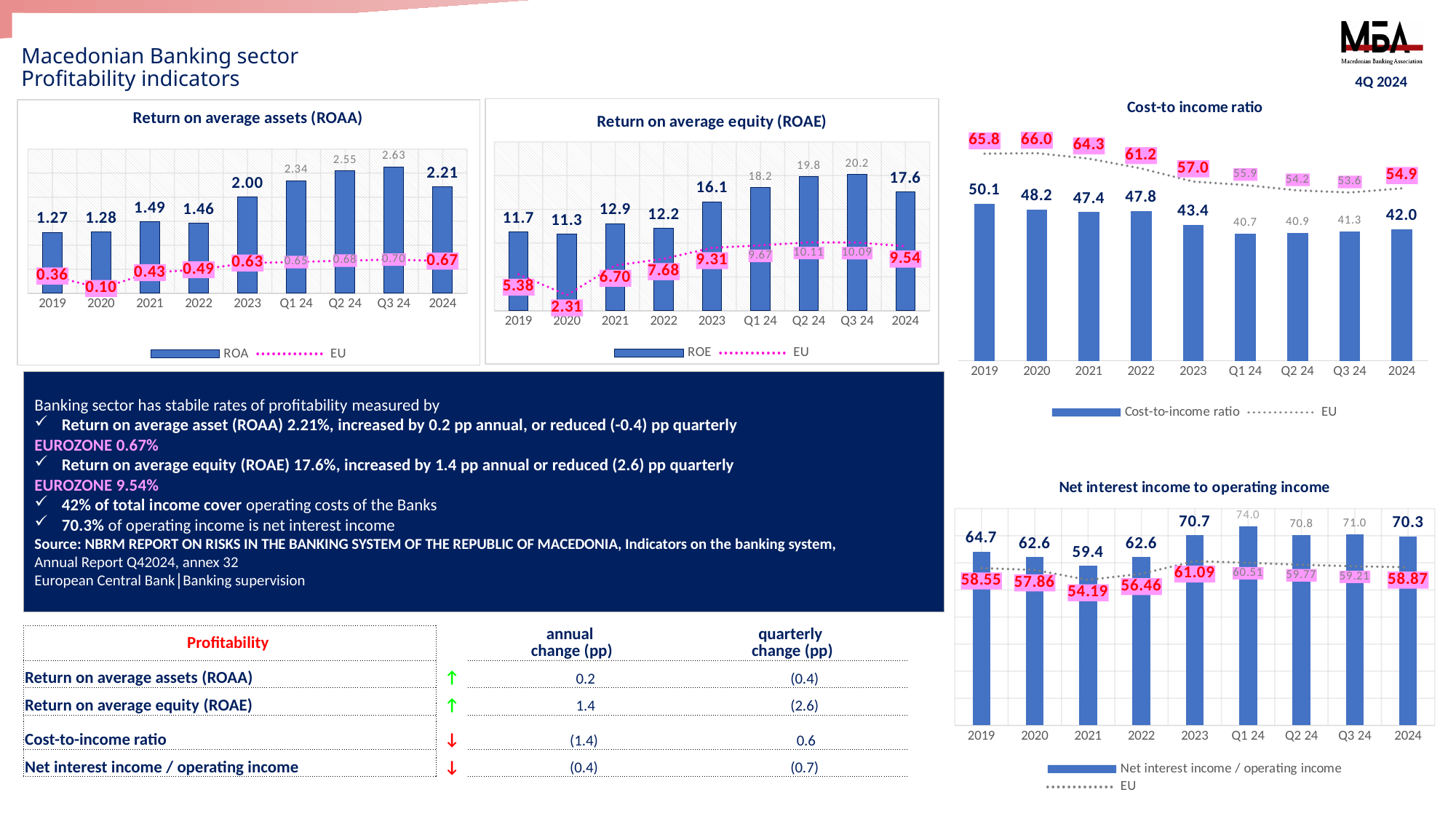
In the Return on average assets (ROAA) chart, which period has the highest ROA value? Q3 24 What type of chart is the Net interest income to operating income chart? Bar chart with a dotted line In the Net interest income to operating income chart, which period has the highest Net interest income / operating income value? Q1 24 In the Return on average equity (ROAE) chart, what is the difference between the ROE value for Q3 24 and the ROE value for 2024? 2.6 In the Cost-to income ratio chart, how many periods are shown on the x axis? 9 In the Net interest income to operating income chart, what is the EU value for 2021? 54.19 In the Cost-to income ratio chart, which is larger for 2024: the Cost-to-income ratio or the EU value? EU In the Return on average assets (ROAA) chart, what is the ROA value for 2024? 2.21 In the Cost-to income ratio chart, what is the Cost-to-income ratio value for 2019? 50.1 In the Return on average assets (ROAA) chart, what is the EU value for 2020? 0.10 In the Return on average equity (ROAE) chart, what is the ROE value for 2023? 16.1 In the Return on average equity (ROAE) chart, which period has the lowest EU value? 2020